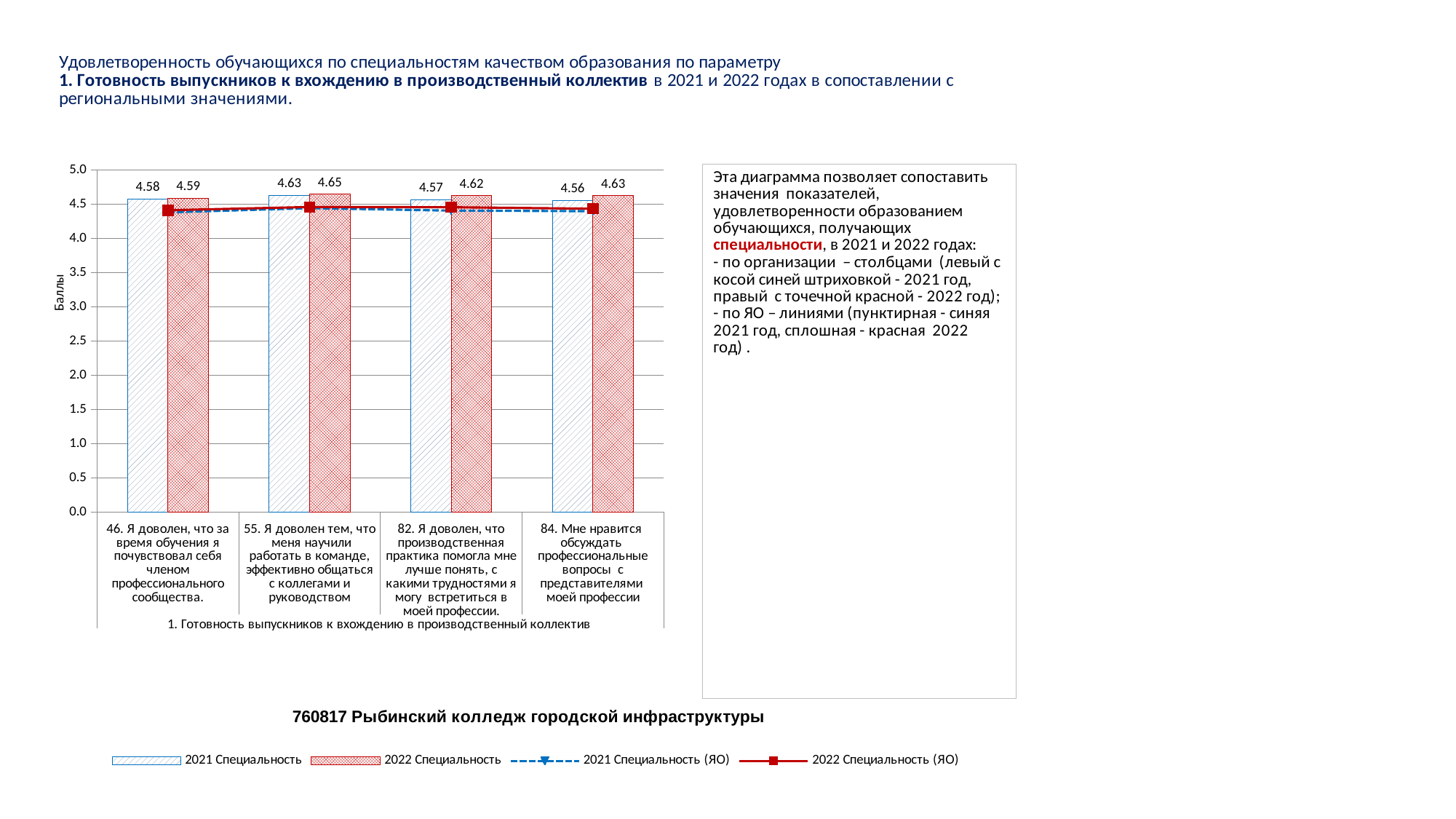
For category 82 (Я доволен, что производственная практика помогла мне...), which is larger: the 2021 Специальность value or the 2022 Специальность value? 2022 Специальность Is the value of the 2022 Специальность (ЯО) line for category 46 greater or less than 4.0? greater How many series does the legend list? 4 For category 84 (Мне нравится обсуждать профессиональные вопросы...), what is the difference between the 2022 Специальность and 2021 Специальность values? 0.07 What is the value of the 2022 Специальность bar for category "55. Я доволен тем, что меня научили работать в команде, эффективно общаться с коллегами и руководством"? 4.65 Which category has the highest 2022 Специальность value? 55. Я доволен тем, что меня научили работать в команде, эффективно общаться с коллегами и руководством What is the value of the 2022 Специальность bar for category "82. Я доволен, что производственная практика помогла мне лучше понять, с какими трудностями я могу встретиться в моей профессии."? 4.62 What kind of chart is shown on the slide? bar chart (with line series) Which category has the lowest 2021 Специальность value? 84. Мне нравится обсуждать профессиональные вопросы с представителями моей профессии What is the value of the 2021 Специальность bar for category "46. Я доволен, что за время обучения я почувствовал себя членом профессионального сообщества."? 4.58 How many categories are shown on the x axis of the chart? 4 What is the value of the 2021 Специальность bar for category "84. Мне нравится обсуждать профессиональные вопросы с представителями моей профессии"? 4.56